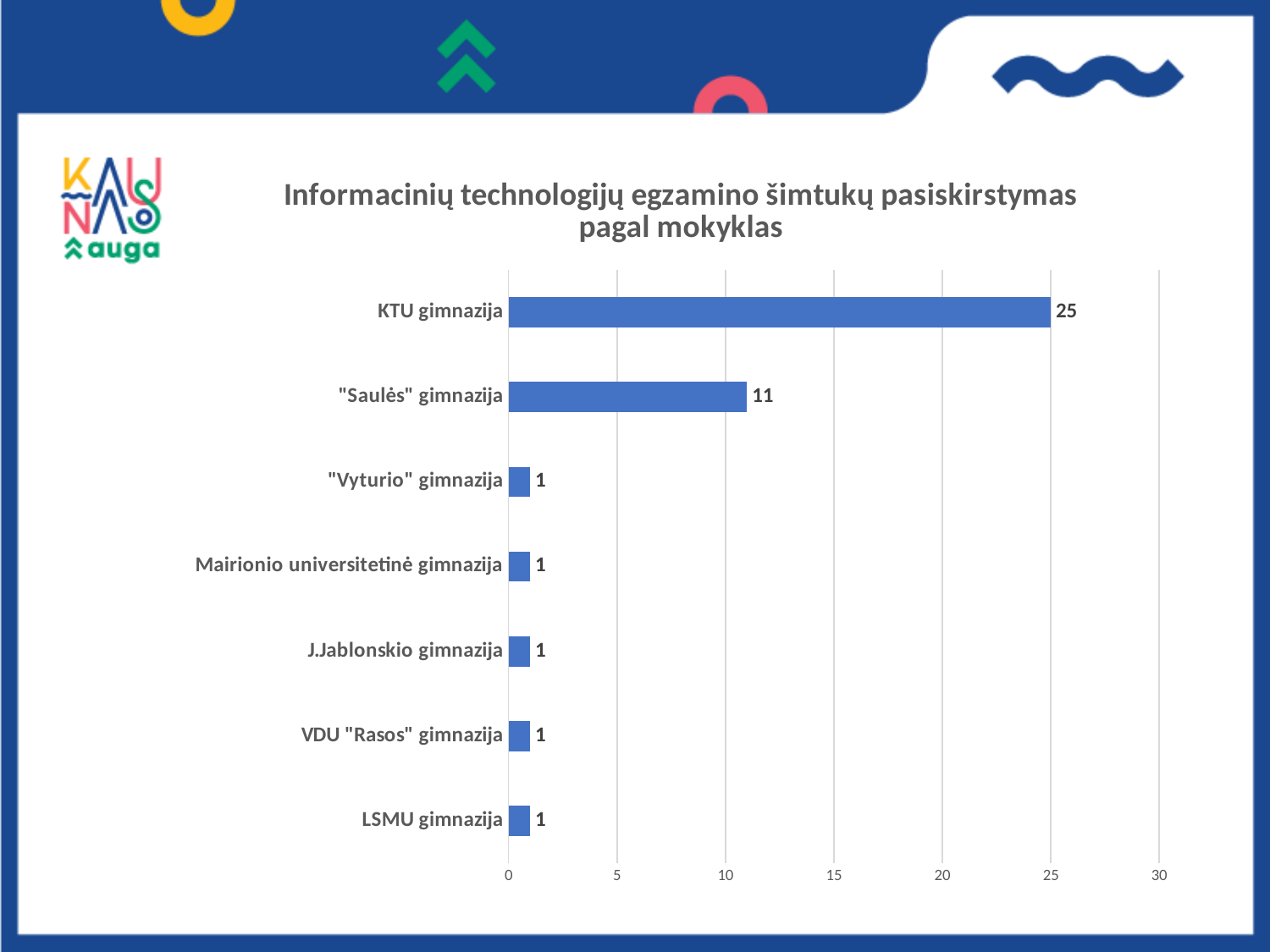
What is the title of the chart? Informacinių technologijų egzamino šimtukų pasiskirstymas pagal mokyklas What is the value for LSMU gimnazija? 1 Which is larger, the value for "Saulės" gimnazija or the value for "Vyturio" gimnazija? "Saulės" gimnazija How many schools are shown in the chart? 7 Is the value for KTU gimnazija greater or less than 20? greater What is the value for "Saulės" gimnazija? 11 How many schools have a value of 1? 5 Which school has the highest value? KTU gimnazija What is the difference between the values for KTU gimnazija and "Saulės" gimnazija? 14 What kind of chart is shown on the slide? bar chart What is the value for KTU gimnazija? 25 What is the highest value shown on the x axis? 30